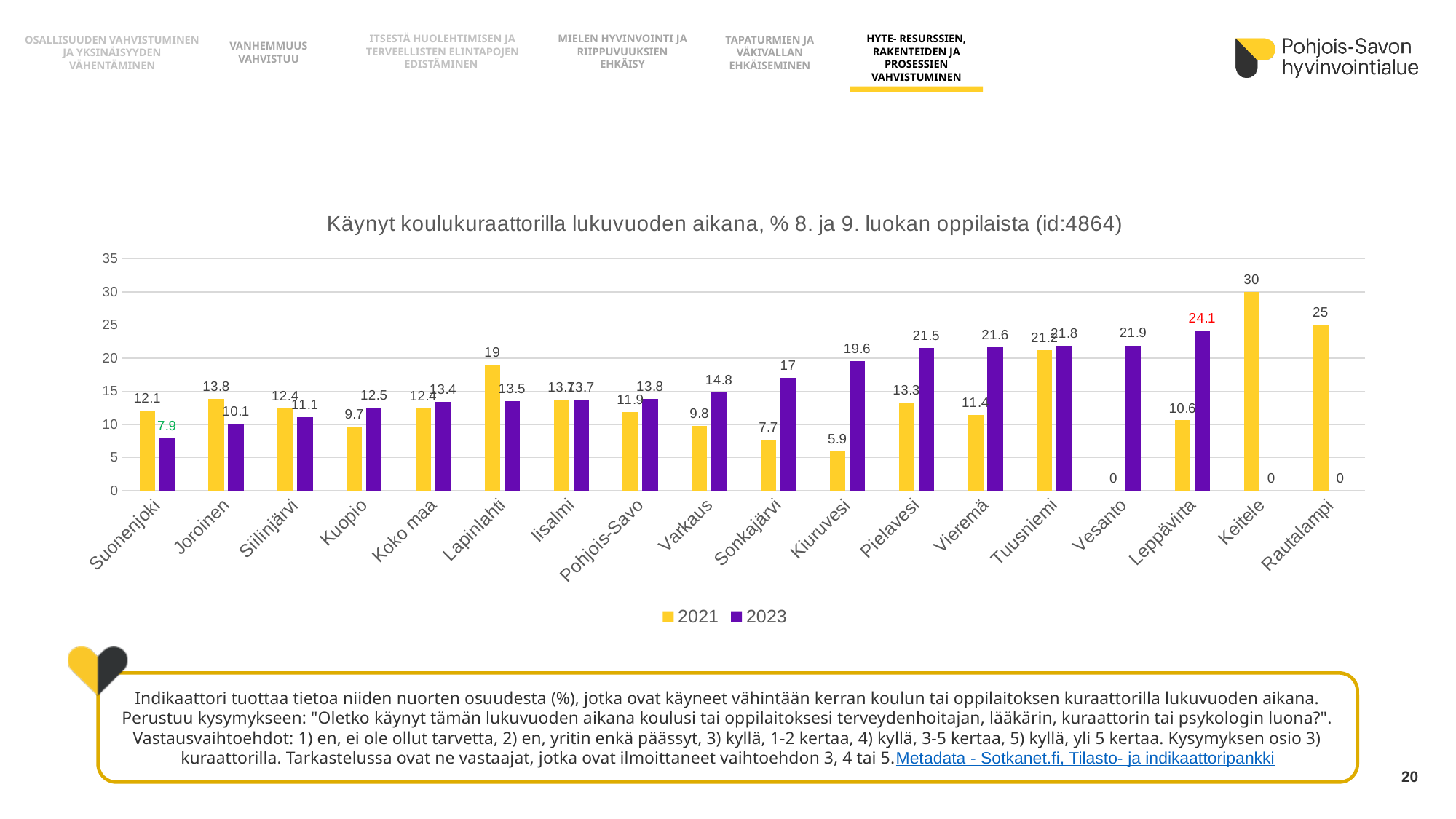
Which category has the highest 2021 value? Keitele Is the 2023 value for Pielavesi greater or less than 20? greater Which category has the highest 2023 value? Leppävirta What is the 2023 value for Koko maa? 13.4 What is the 2023 value for Leppävirta? 24.1 Which category has the lowest 2021 value among those with a non-zero 2021 bar? Kiuruvesi What is the difference between the 2023 and 2021 values for Kiuruvesi? 13.7 For Lapinlahti, which is larger: the 2021 value or the 2023 value? 2021 What is the 2021 value for Kuopio? 9.7 How many series does the legend list? 2 What kind of chart is shown on the slide? Bar chart How many categories are shown on the x axis? 18